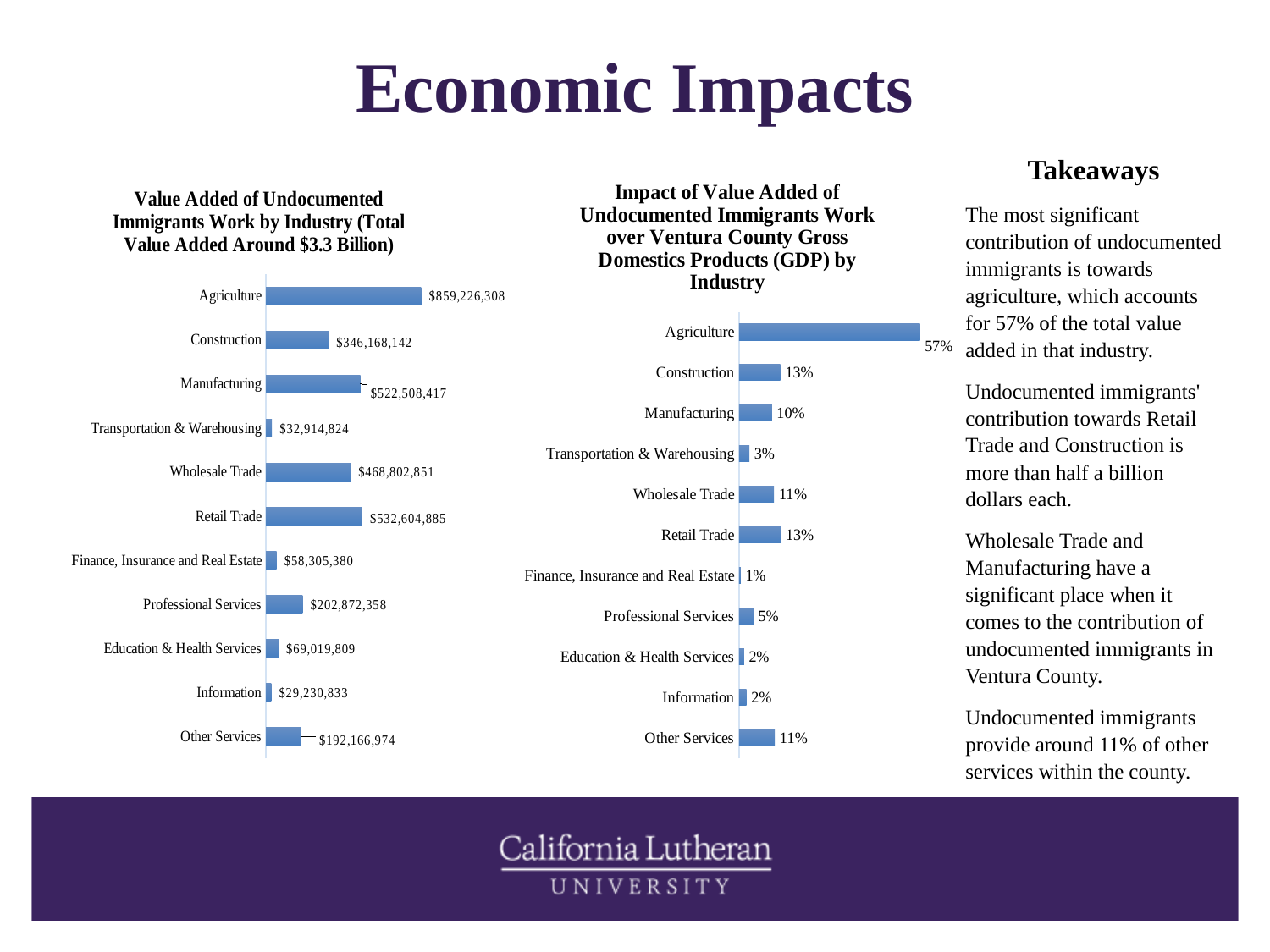
How many industries are shown in the left chart, 'Value Added of Undocumented Immigrants Work by Industry'? 11 In the left chart, 'Value Added of Undocumented Immigrants Work by Industry', what is the value for Agriculture? $859,226,308 In the left chart, 'Value Added of Undocumented Immigrants Work by Industry', what is the difference between the values for Agriculture and Construction? $513,058,166 In the left chart, 'Value Added of Undocumented Immigrants Work by Industry', which industry has the highest value added? Agriculture In the left chart, 'Value Added of Undocumented Immigrants Work by Industry', what is the value for Wholesale Trade? $468,802,851 In the right chart, 'Impact of Value Added of Undocumented Immigrants Work over Ventura County GDP by Industry', what is the difference between the values for Agriculture and Retail Trade? 44% What type of chart is the right chart, 'Impact of Value Added of Undocumented Immigrants Work over Ventura County GDP by Industry'? Bar chart In the left chart, 'Value Added of Undocumented Immigrants Work by Industry', which industry has the lowest value added? Information In the right chart, 'Impact of Value Added of Undocumented Immigrants Work over Ventura County GDP by Industry', what is the value for Professional Services? 5% In the right chart, 'Impact of Value Added of Undocumented Immigrants Work over Ventura County GDP by Industry', what is the value for Agriculture? 57% In the right chart, 'Impact of Value Added of Undocumented Immigrants Work over Ventura County GDP by Industry', which industry has the lowest value? Finance, Insurance and Real Estate In the left chart, 'Value Added of Undocumented Immigrants Work by Industry', which is larger: Professional Services or Other Services? Professional Services